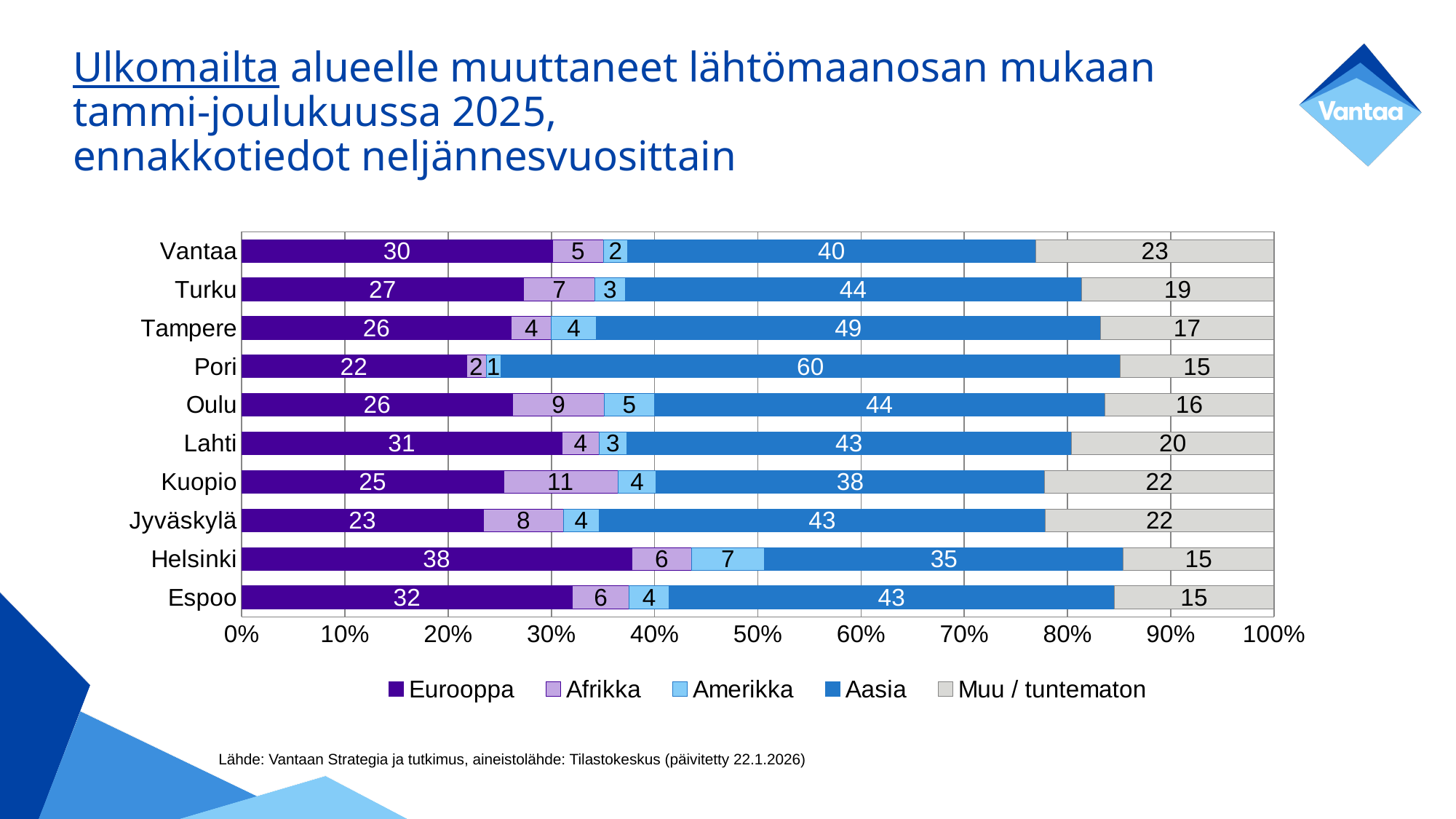
What is the value for Eurooppa for Helsinki? 38 What is the value for Aasia for Vantaa? 40 What is the difference between the Aasia value for Pori and the Aasia value for Kuopio? 22 Which city has the highest value for Aasia? Pori Which city has the lowest value for Aasia? Helsinki What is the value for Afrikka for Kuopio? 11 Which is larger: the Muu / tuntematon value for Vantaa or for Turku? Vantaa How many series does the legend list? 5 Which city has the highest value for Eurooppa? Helsinki How many cities are shown on the chart? 10 What kind of chart is shown on the slide? Stacked bar chart What is the total of the stacked bar for Vantaa? 100